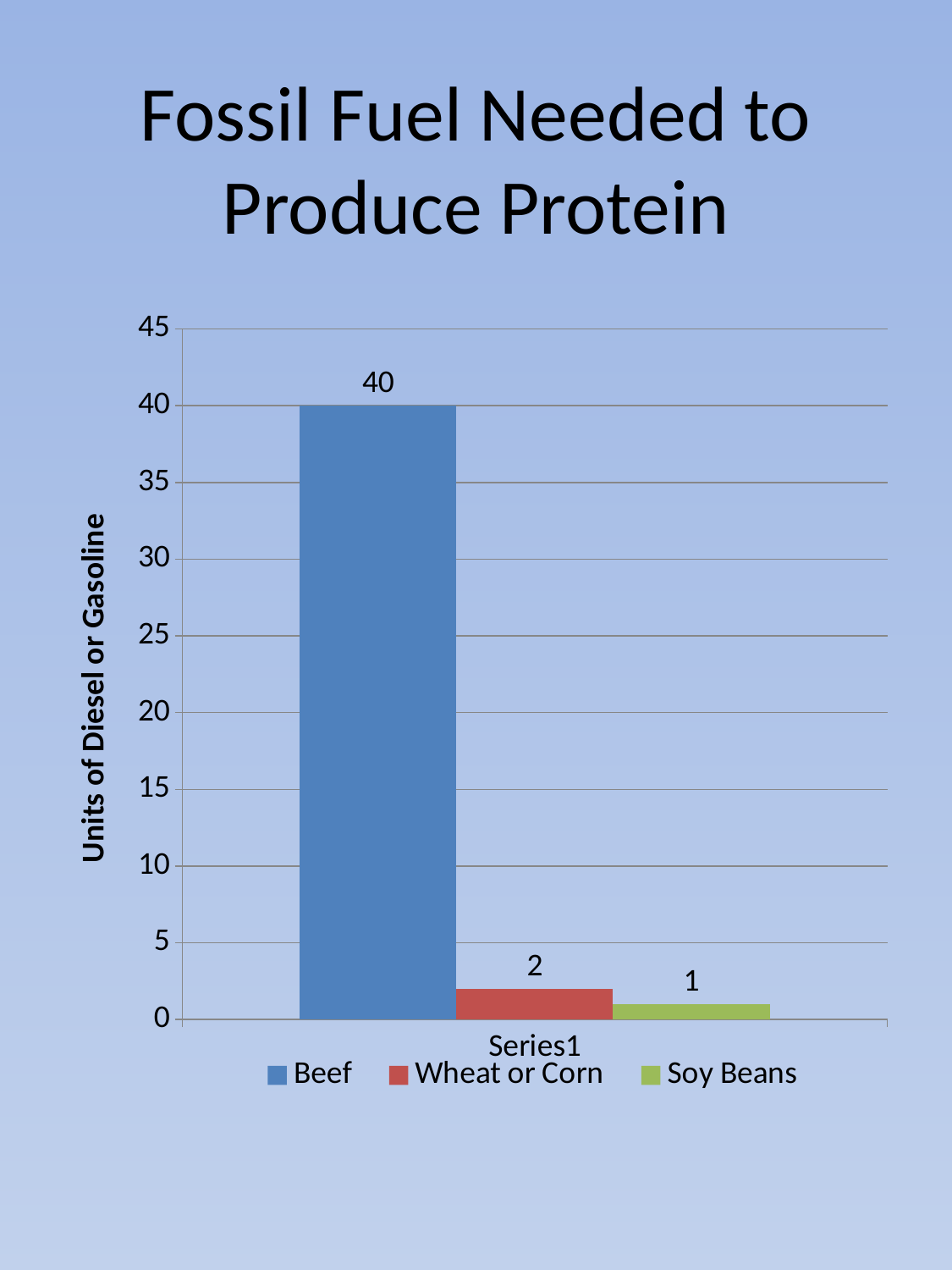
What is the difference between the values for Wheat or Corn and Soy Beans? 1 What is the difference between the values for Beef and Wheat or Corn? 38 How many series does the legend list? 3 Which is larger, the value for Beef or the value for Soy Beans? Beef Which series has the lowest value? Soy Beans What is the value for Beef? 40 What is the value for Wheat or Corn? 2 What kind of chart is shown on the slide? bar chart Which series has the highest value? Beef What is the label of the vertical axis? Units of Diesel or Gasoline What is the value for Soy Beans? 1 Is the value for Beef greater or less than 35? greater